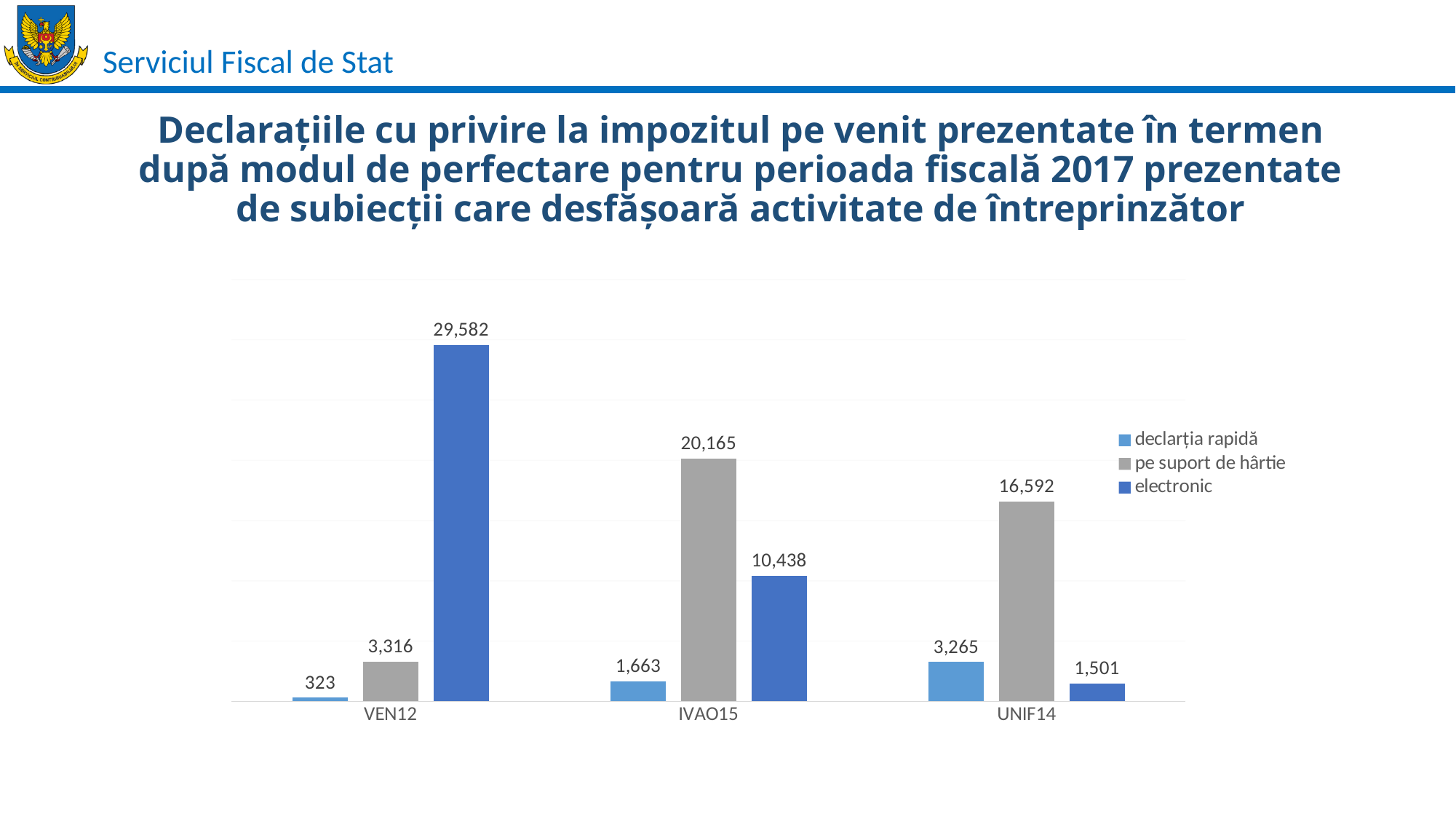
What is the difference between the 'pe suport de hârtie' and 'electronic' values for IVAO15? 9,727 What is the value for 'electronic' in the UNIF14 category? 1,501 What is the value for 'declarția rapidă' in the UNIF14 category? 3,265 Which is larger for UNIF14: 'pe suport de hârtie' or 'electronic'? pe suport de hârtie How many categories are shown on the x axis? 3 What kind of chart is shown on the slide? bar chart What is the value for 'electronic' in the VEN12 category? 29,582 Which category has the lowest 'declarția rapidă' value? VEN12 How many series does the legend list? 3 Which category has the highest 'electronic' value? VEN12 What is the value for 'pe suport de hârtie' in the IVAO15 category? 20,165 Which series is shown in grey in the legend? pe suport de hârtie